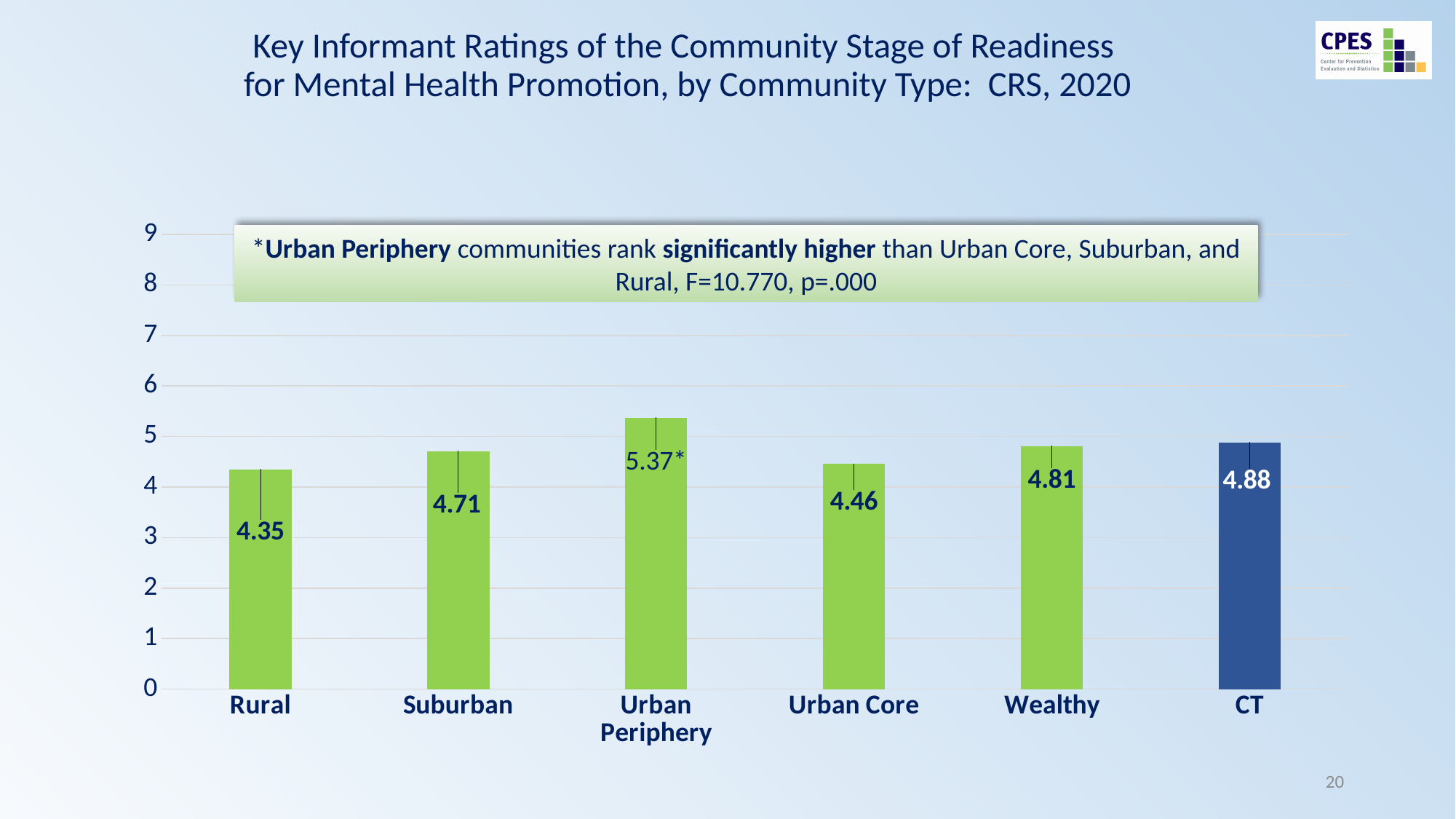
Which has a higher rating, Suburban or Urban Core? Suburban What kind of chart is shown on the slide? Bar chart What is the rating for Rural communities? 4.35 Which bar is shown in a different colour (dark blue) from the others? CT What is the rating for CT? 4.88 What is the difference between the Urban Periphery rating and the Rural rating? 1.02 What is the rating for Urban Periphery communities? 5.37 Which community type has the highest rating? Urban Periphery How many community types are shown on the x axis? 6 Is the value for Urban Periphery greater or less than 5? greater What is the difference between the CT rating and the Wealthy rating? 0.07 Which community type has the lowest rating? Rural